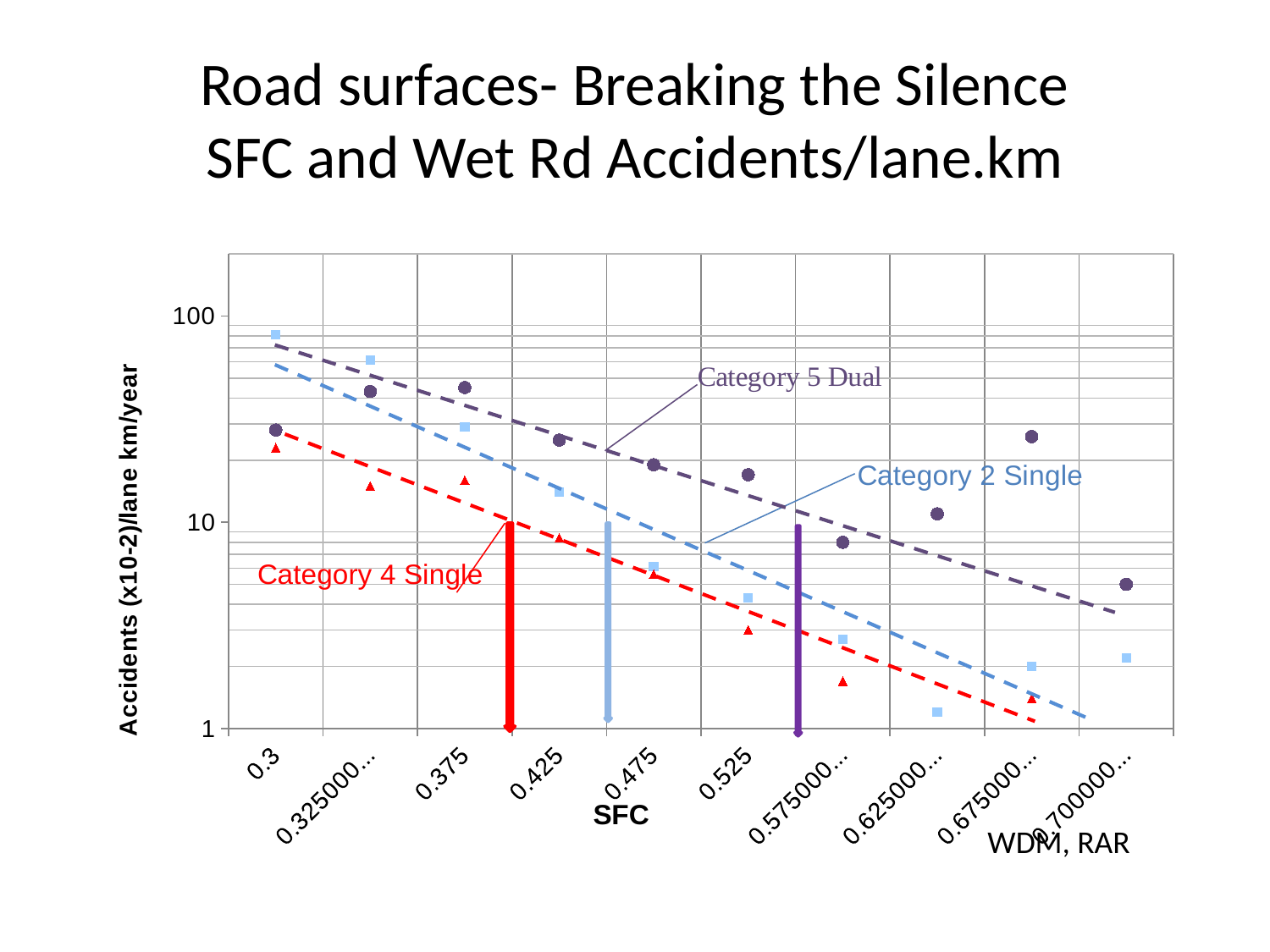
Which series has the highest value at SFC 0.3? Category 2 Single How many data series are labelled on the chart? 3 Do the accident values rise or fall as SFC increases along the x axis? Fall Is the Category 2 Single value at SFC 0.625 greater or less than 10? less What is the title of the x axis? SFC Is the Category 2 Single value at SFC 0.3 greater or less than 10? greater At SFC 0.3, which series has the higher value: Category 2 Single or Category 4 Single? Category 2 Single Is the Category 4 Single value at SFC 0.525 greater or less than 10? less What kind of chart is shown on the slide? Scatter chart What is the title of the y axis? Accidents (x10-2)/lane km/year